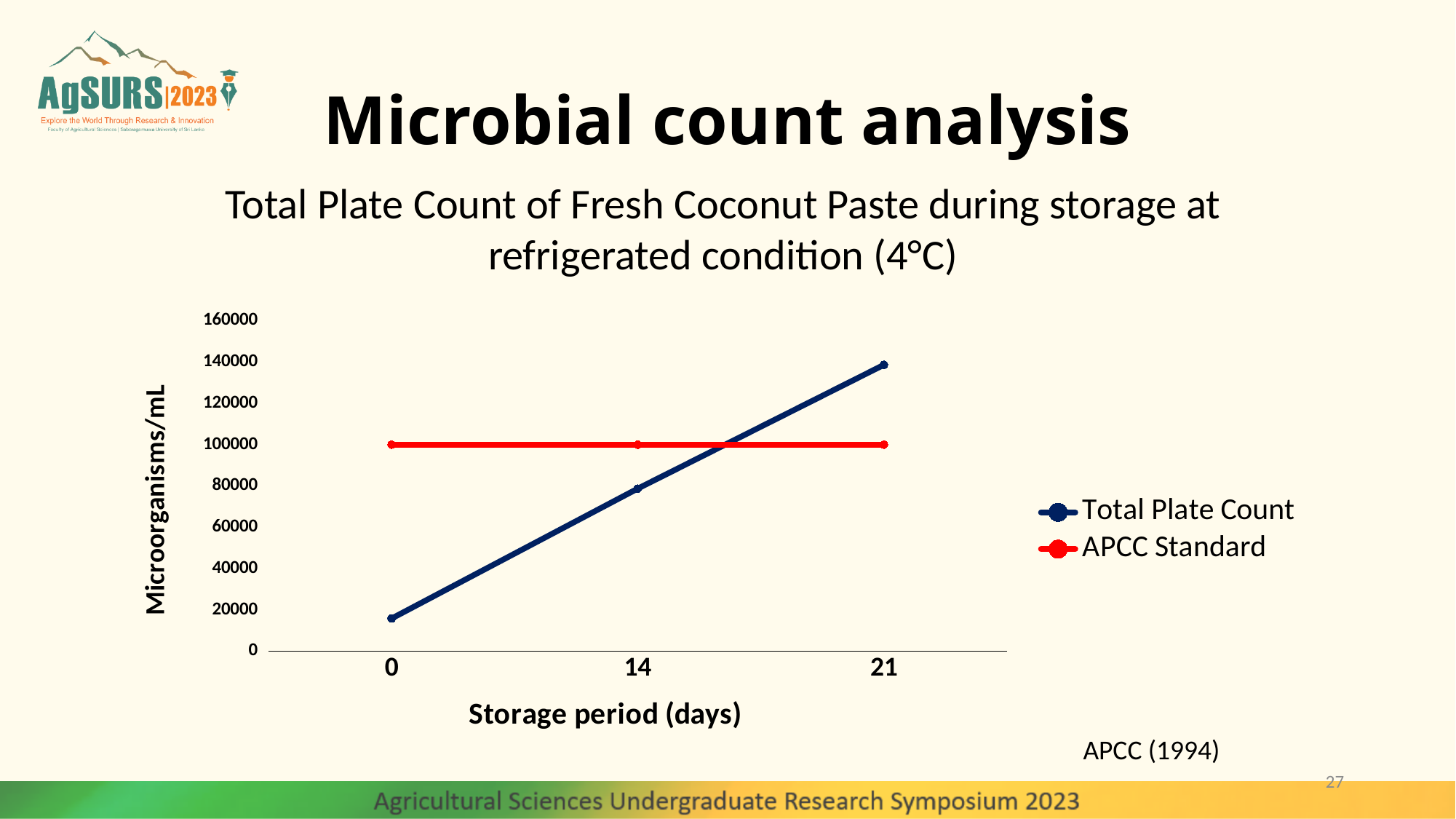
At which storage period is the Total Plate Count highest? 21 What colour is the APCC Standard line? red Does the Total Plate Count rise or fall as the storage period increases? rise At day 21, which is larger: the Total Plate Count or the APCC Standard? Total Plate Count Is the Total Plate Count at day 0 greater or less than 20000? less What kind of chart is shown on the slide? line chart Is the Total Plate Count at day 21 greater or less than 120000? greater How many storage period points are plotted on the x axis? 3 What is the label of the y axis? Microorganisms/mL How many series does the legend list? 2 What is the value of the APCC Standard line? 100000 Is the Total Plate Count at day 14 greater or less than 100000? less